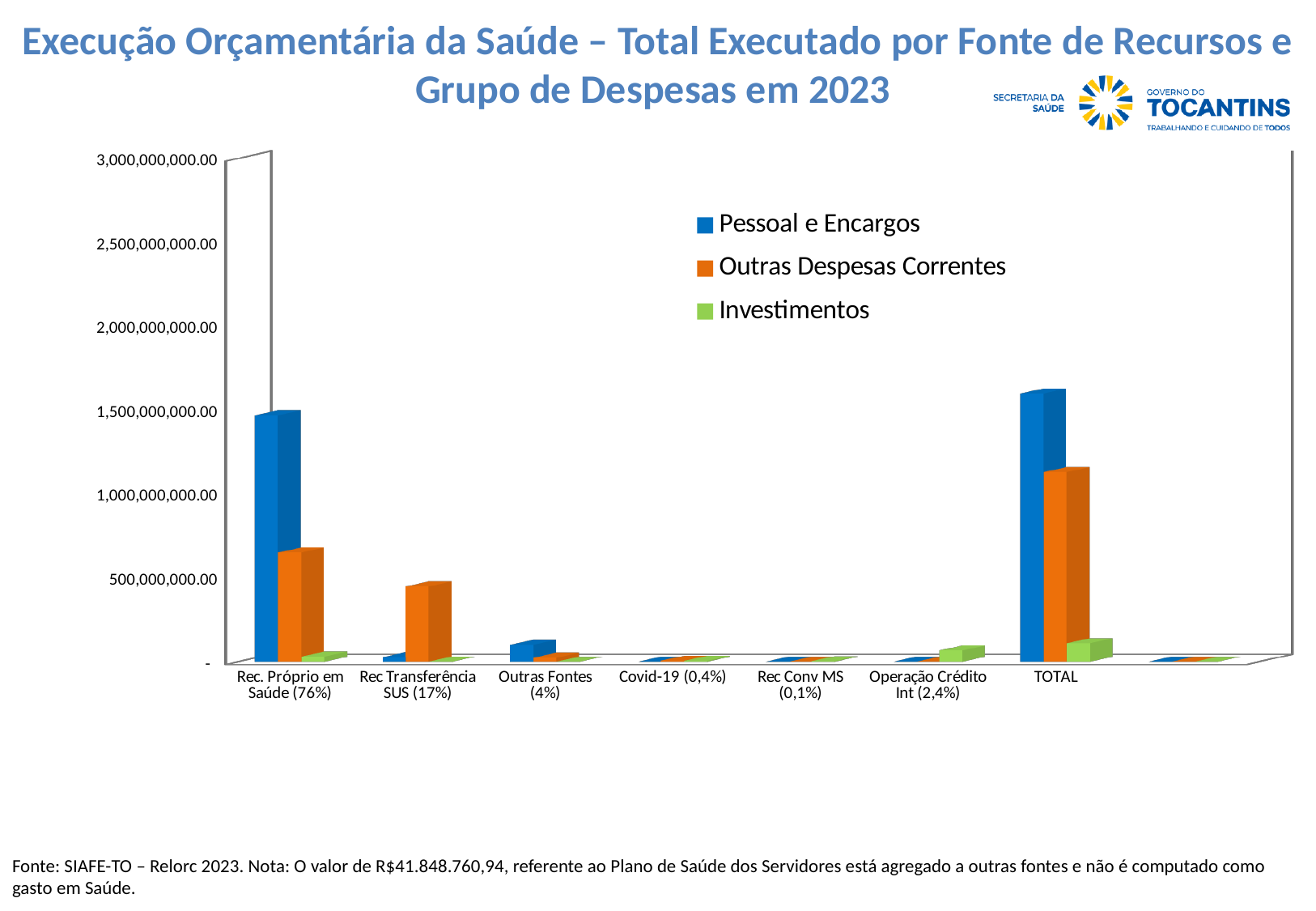
What colour represents Investimentos in the legend? green Excluding TOTAL, which funding source has the highest Pessoal e Encargos value? Rec. Próprio em Saúde (76%) For Rec. Próprio em Saúde (76%), which is larger: Pessoal e Encargos or Outras Despesas Correntes? Pessoal e Encargos What kind of chart is shown on the slide? bar chart Is the Outras Despesas Correntes value for TOTAL greater or less than 1,000,000,000.00? greater How many categories are shown on the x axis? 7 For Rec Transferência SUS (17%), which series has the largest value? Outras Despesas Correntes How many series does the legend list? 3 Which category has the tallest Pessoal e Encargos bar? TOTAL Is the Pessoal e Encargos value for Rec. Próprio em Saúde (76%) greater or less than 1,000,000,000.00? greater